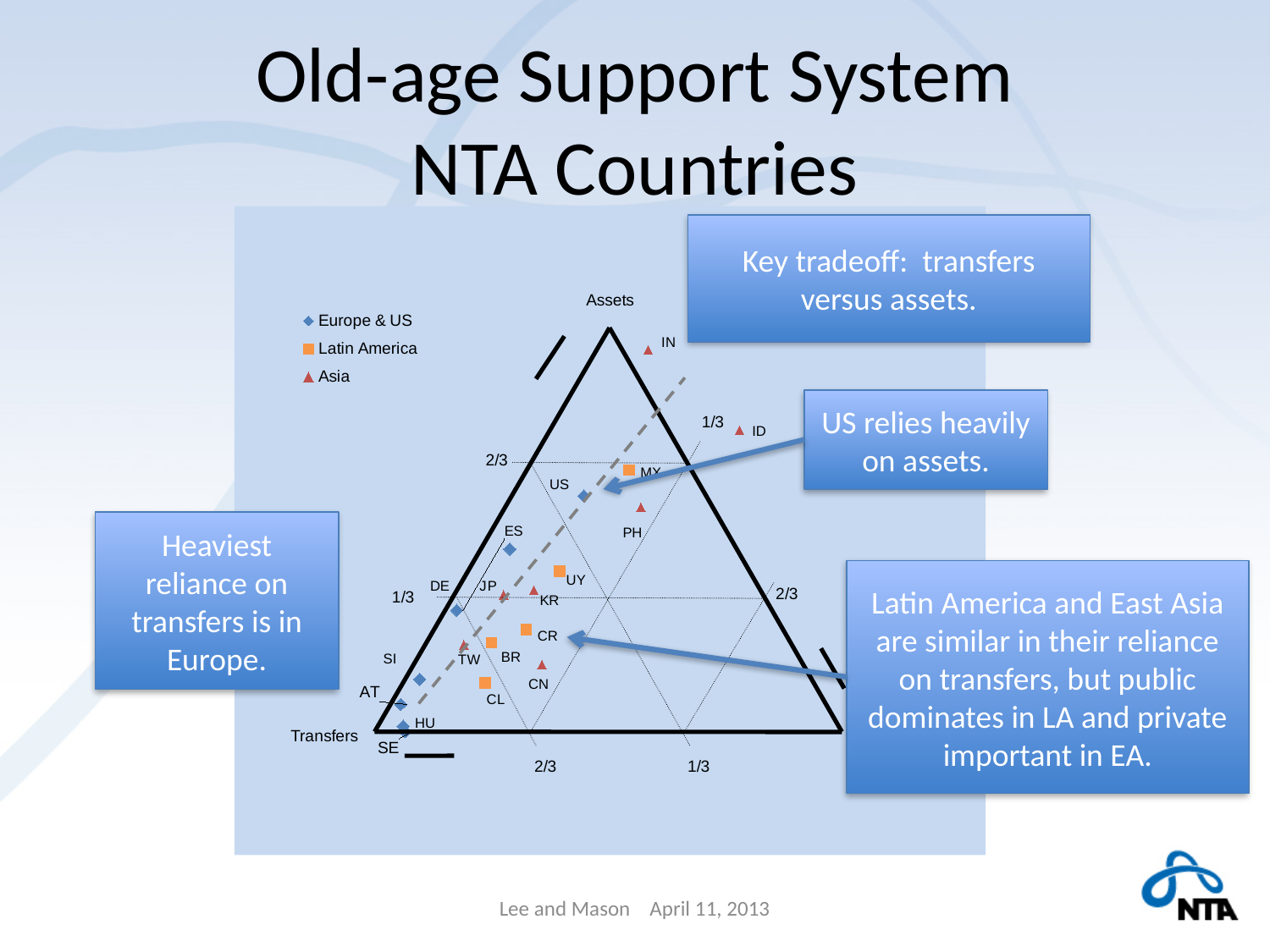
Which point is closer to the Assets vertex, IN or ID? IN Is the assets share for IN greater or less than 2/3? greater Which series does the point labelled MX belong to? Latin America Which series does the point labelled KR belong to? Asia Which three series are listed in the legend? Europe & US, Latin America, Asia What are the three vertices (axes) of the triangle labelled? Assets, Transfers (and an unlabelled third vertex) Is the assets share for US greater or less than 1/3? greater Which country point lies closest to the Transfers vertex? SE Which series does the point labelled US belong to? Europe & US What kind of chart is shown on the slide? Ternary (triangle) scatter plot Which country point lies closest to the Assets vertex? IN How many series does the legend list? 3